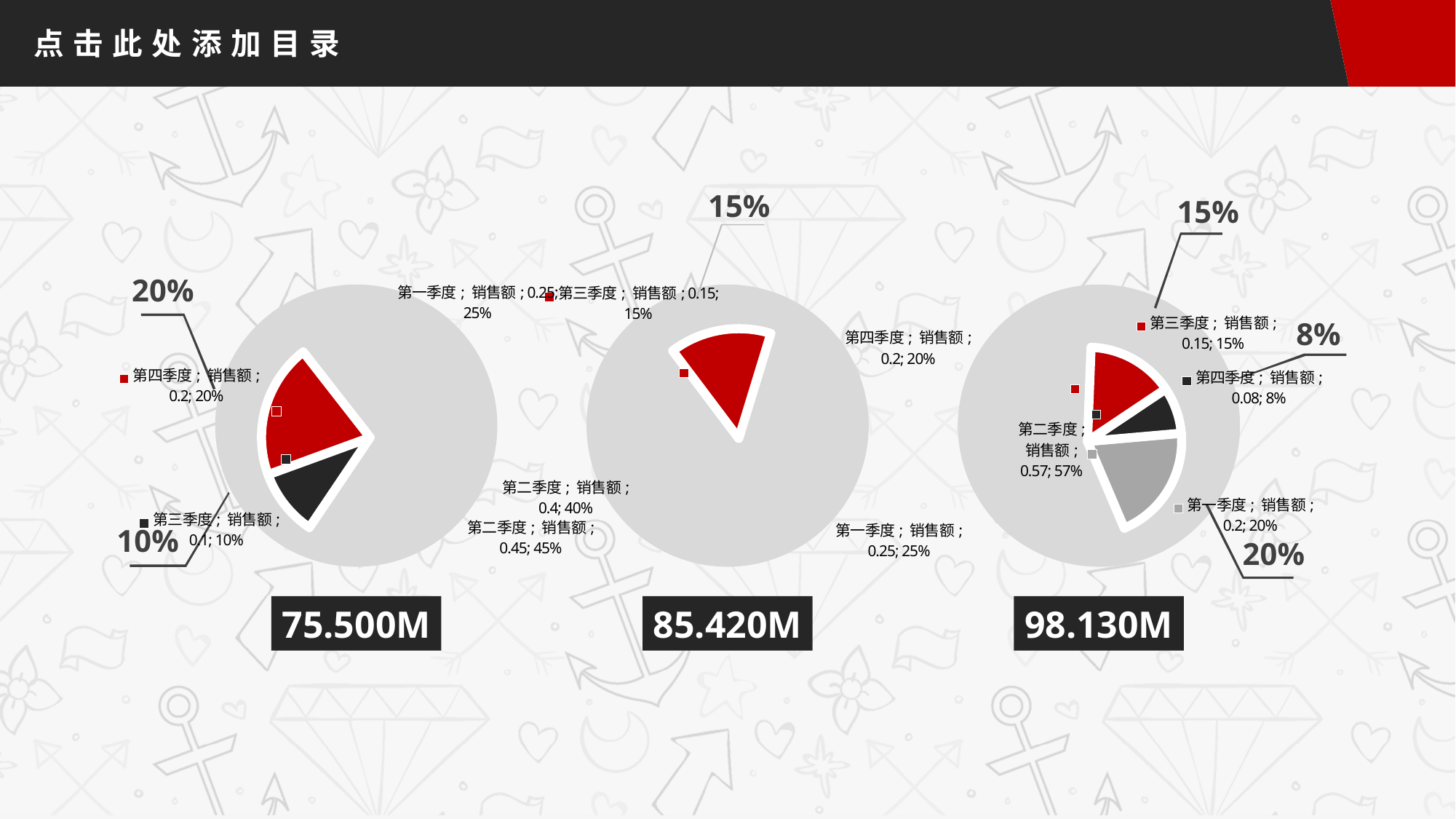
In the middle chart (above 85.420M), what percentage is shown for 第二季度? 40% In the left chart (above 75.500M), what is the 销售额 value shown for 第四季度? 0.2 In the left chart (above 75.500M), which quarter has the smallest share? 第三季度 What total figure is printed below the middle chart? 85.420M In the right chart (above 98.130M), what percentage is shown for 第四季度? 8% In the right chart (above 98.130M), what is the 销售额 value shown for 第二季度? 0.57 How many quarters are labelled in the right chart (above 98.130M)? 4 What kind of chart is the left chart (above 75.500M)? pie chart In the middle chart (above 85.420M), which quarter has the largest share? 第二季度 In the middle chart (above 85.420M), what is the difference in percentage points between 第一季度 (25%) and 第三季度 (15%)? 10 In the right chart (above 98.130M), which is larger, the share for 第一季度 or 第三季度? 第一季度 In the left chart (above 75.500M), what percentage is shown for 第二季度? 45%